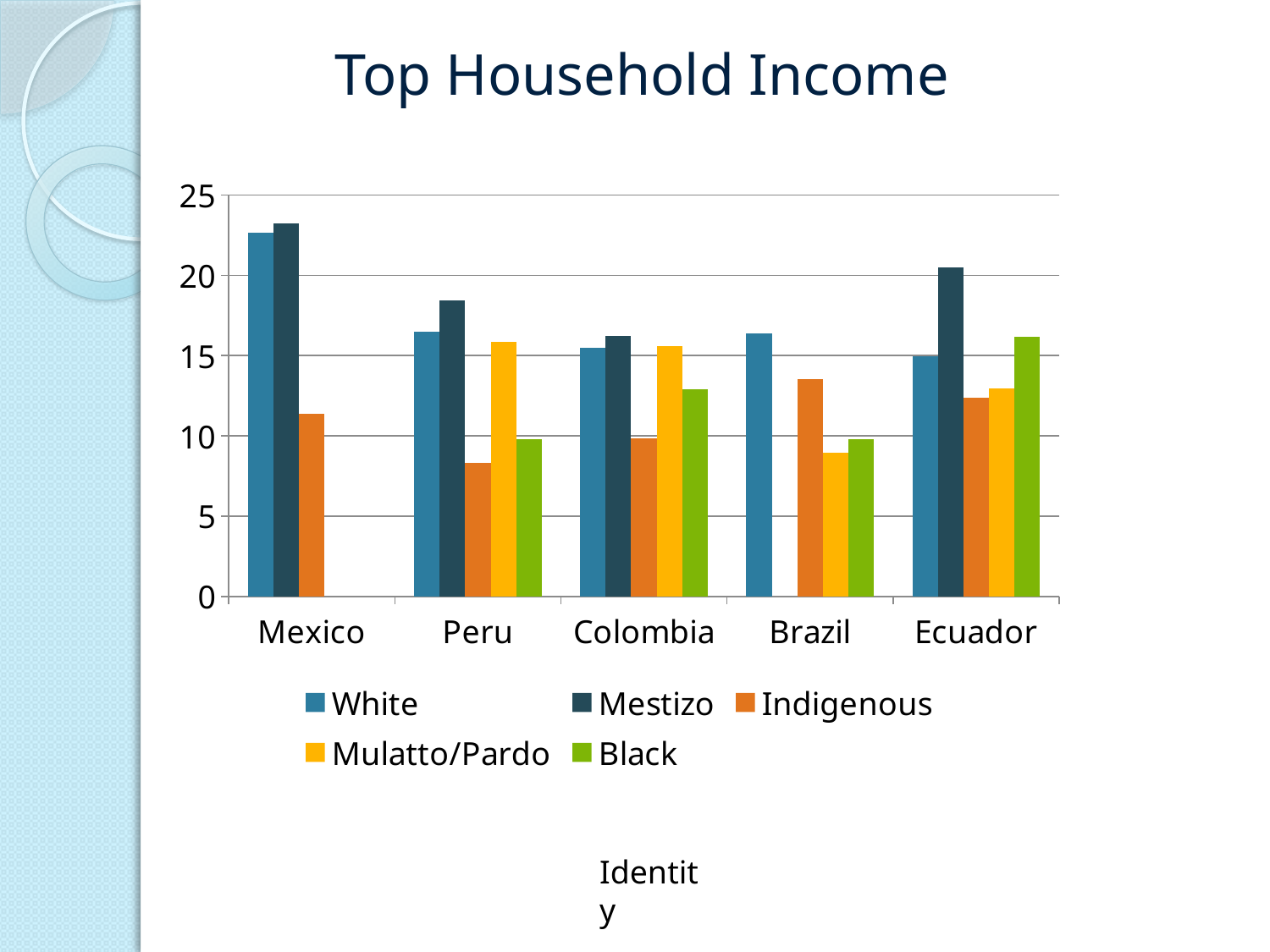
Which country has the highest Mestizo bar? Mexico What is the title of the chart? Top Household Income How many countries are shown on the x axis? 5 Is the value for Indigenous in Peru greater or less than 10? less Is the value for White in Mexico greater or less than 20? greater Which country has the lowest Indigenous bar? Peru What kind of chart is shown on the slide? bar chart Is the value for Black in Colombia greater or less than 15? less In Mexico, which is larger: the Mestizo bar or the Indigenous bar? Mestizo In Ecuador, which is larger: the Mestizo bar or the White bar? Mestizo How many series does the legend list? 5